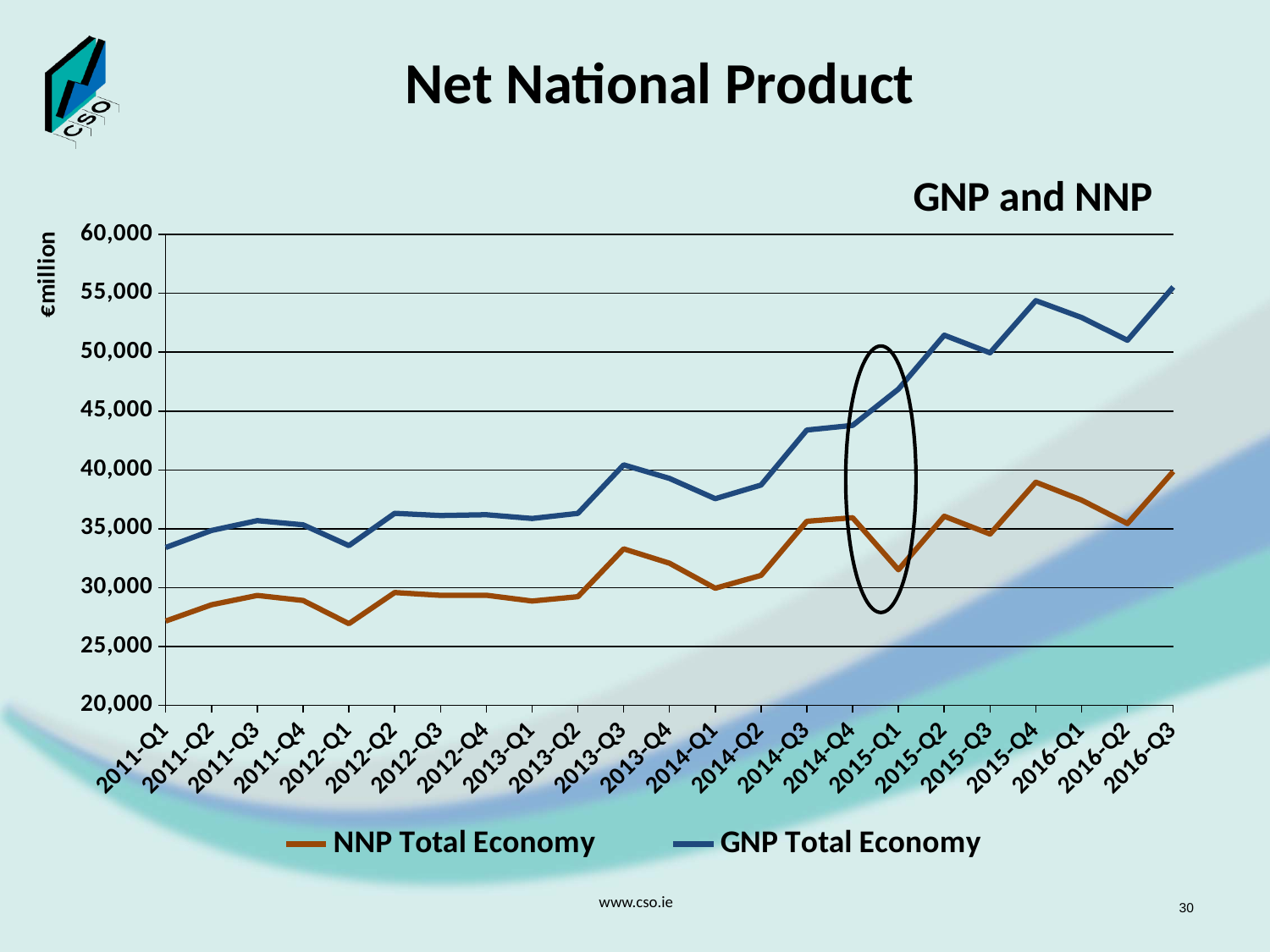
What unit is shown on the y axis label? €million How many quarters are plotted along the x axis? 23 Is the value for NNP Total Economy in 2011-Q1 greater or less than 25,000? greater Which series has the higher value in 2016-Q3, NNP Total Economy or GNP Total Economy? GNP Total Economy What is the title of the chart? GNP and NNP Is the value for GNP Total Economy in 2014-Q3 greater or less than 45,000? less How many series does the legend list? 2 Is the value for GNP Total Economy in 2015-Q2 greater or less than 50,000? greater Overall, do the GNP Total Economy values rise or fall from 2011-Q1 to 2016-Q3? Rise What kind of chart is shown on the slide? Line chart In which quarter does GNP Total Economy reach its highest value? 2016-Q3